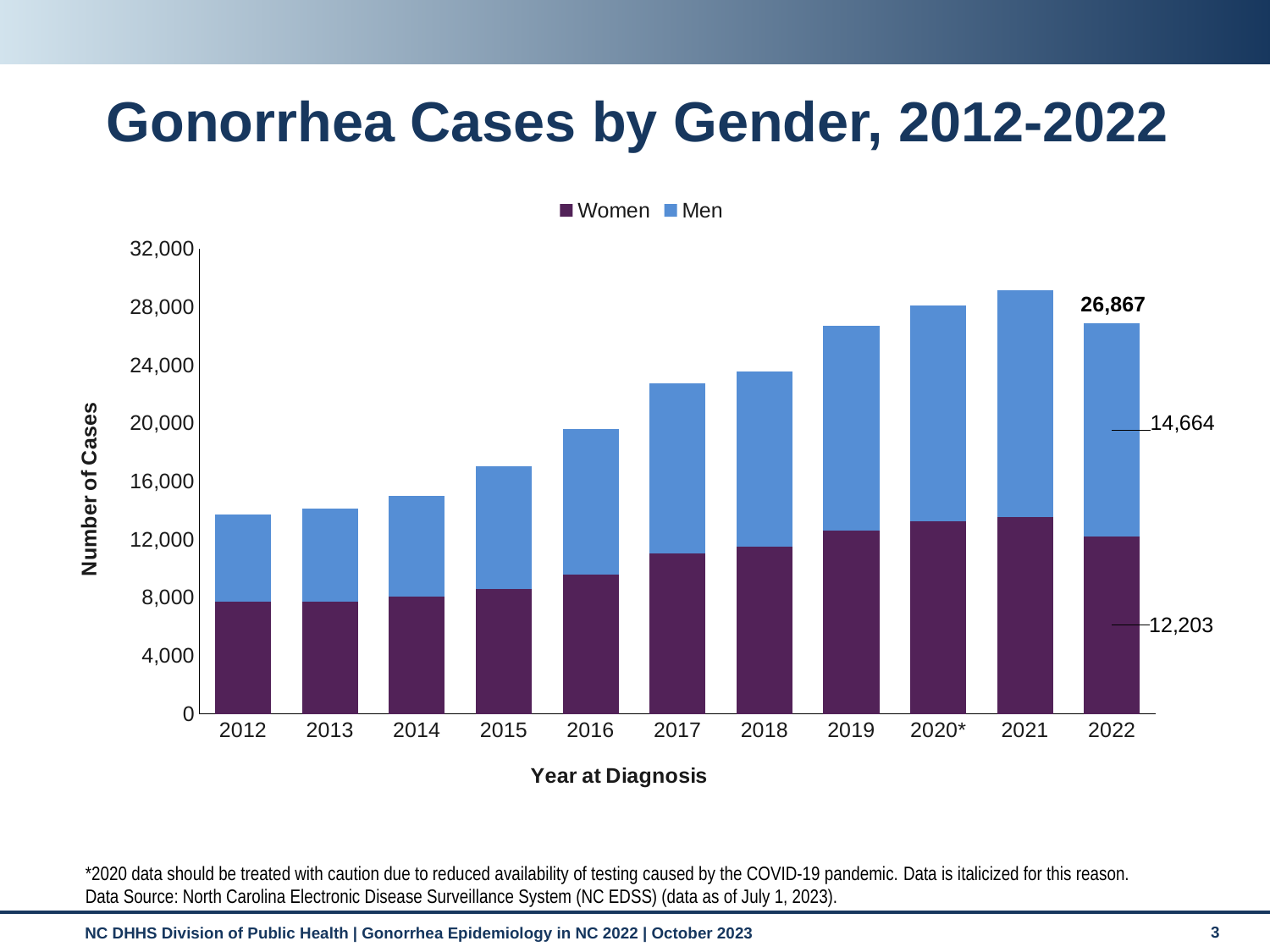
Is the number of cases among women in 2016 greater or less than 12,000? less How many series does the legend list? 2 Is the total number of cases in 2017 greater or less than 20,000? greater What is the total number of gonorrhea cases shown for 2022? 26,867 Which year has the highest total number of cases? 2021 What is the number of gonorrhea cases among men in 2022? 14,664 In 2022, which group had more cases, women or men? Men How many years are shown on the x axis? 11 In 2022, how many more cases were there among men than among women? 2,461 What kind of chart is shown on the slide? Stacked bar chart Is the total number of cases in 2012 greater or less than 16,000? less What is the number of gonorrhea cases among women in 2022? 12,203